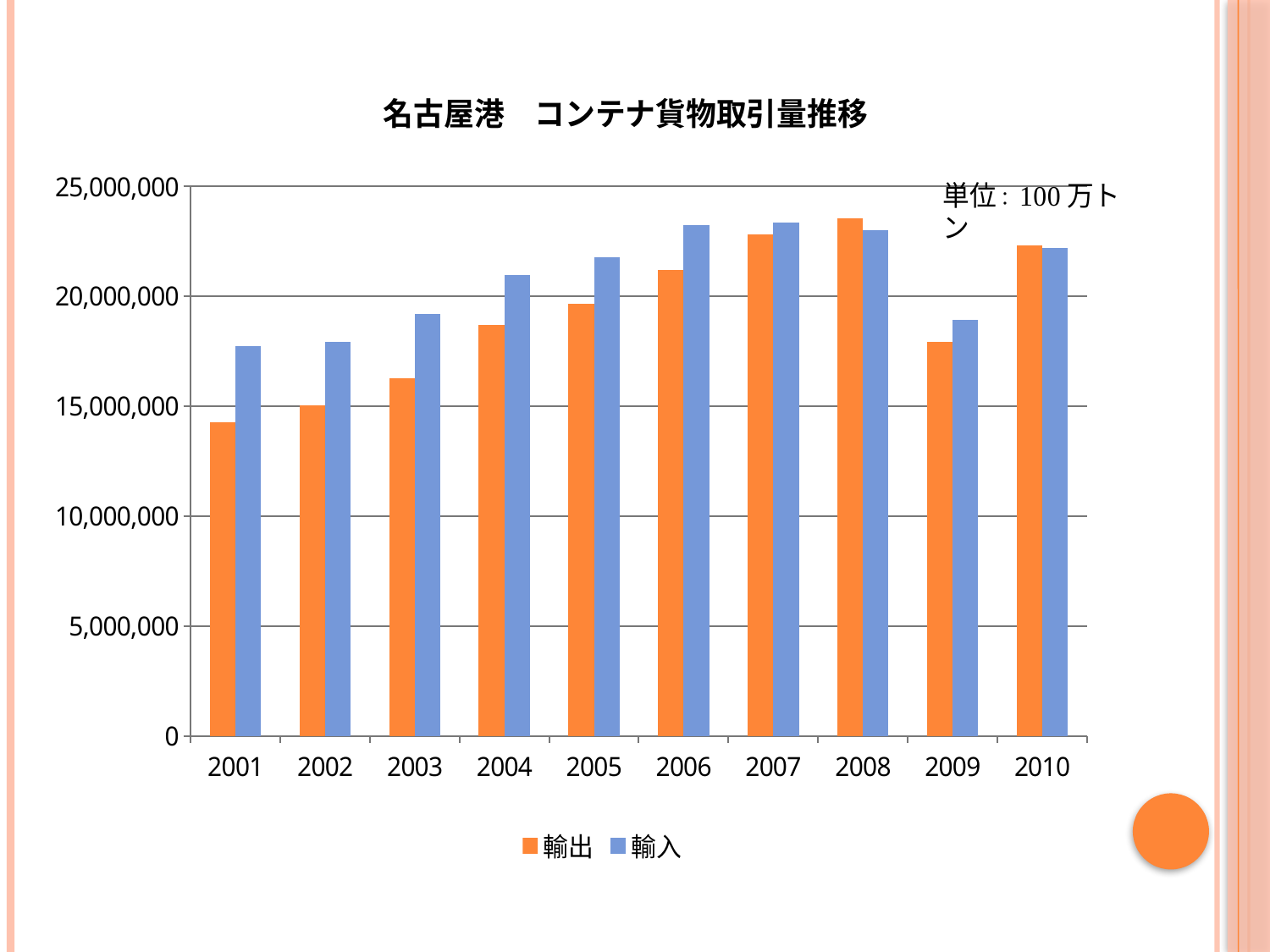
Which year has the lowest value for 輸出? 2001 What kind of chart is shown on the slide? bar chart How many years are shown on the x axis of the chart? 10 Which year has the highest value for 輸出? 2008 Which year has the lowest value for 輸入? 2001 In 2008, which is larger, 輸出 or 輸入? 輸出 Does the value for 輸出 rise or fall from 2001 to 2008? rise Is the value for 輸出 in 2009 greater or less than 20,000,000? less Is the value for 輸出 in 2001 greater or less than 15,000,000? less Is the value for 輸入 in 2001 greater or less than 15,000,000? greater In 2001, which is larger, 輸出 or 輸入? 輸入 How many series does the legend list? 2